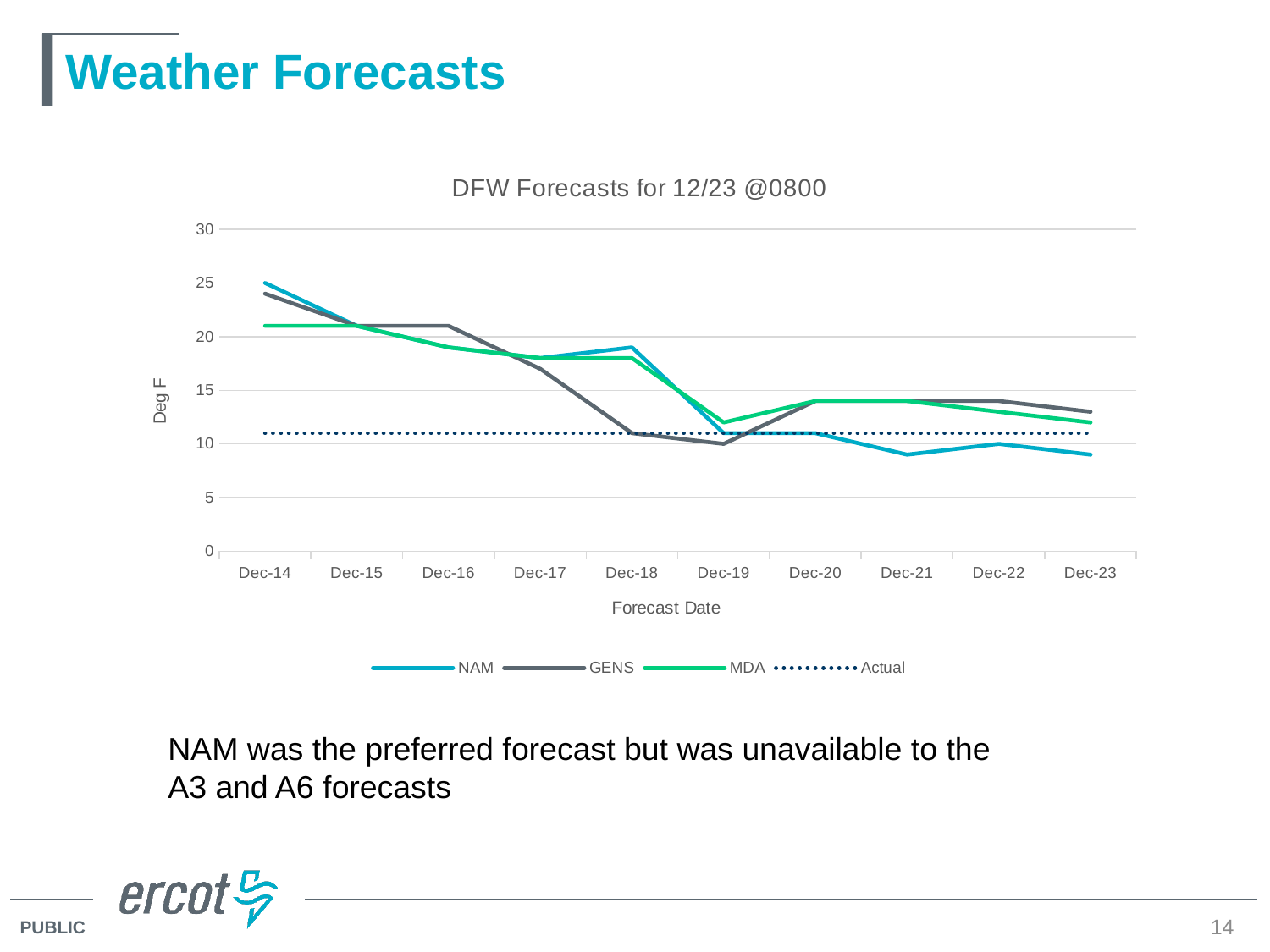
Is the MDA value on Dec-14 greater or less than 20? greater On Dec-18, which is larger, the NAM value or the GENS value? NAM What is the title of the chart? DFW Forecasts for 12/23 @0800 Which series is drawn as a dotted line? Actual Is the GENS value on Dec-21 greater or less than 10? greater What type of chart is shown on the slide? Line chart Which series has the highest value on Dec-14? NAM Which series has the lowest value on Dec-23? NAM Is the NAM value on Dec-21 greater or less than 10? less How many series does the legend list? 4 What is the NAM value on Dec-14? 25 How many forecast dates are shown on the x axis? 10